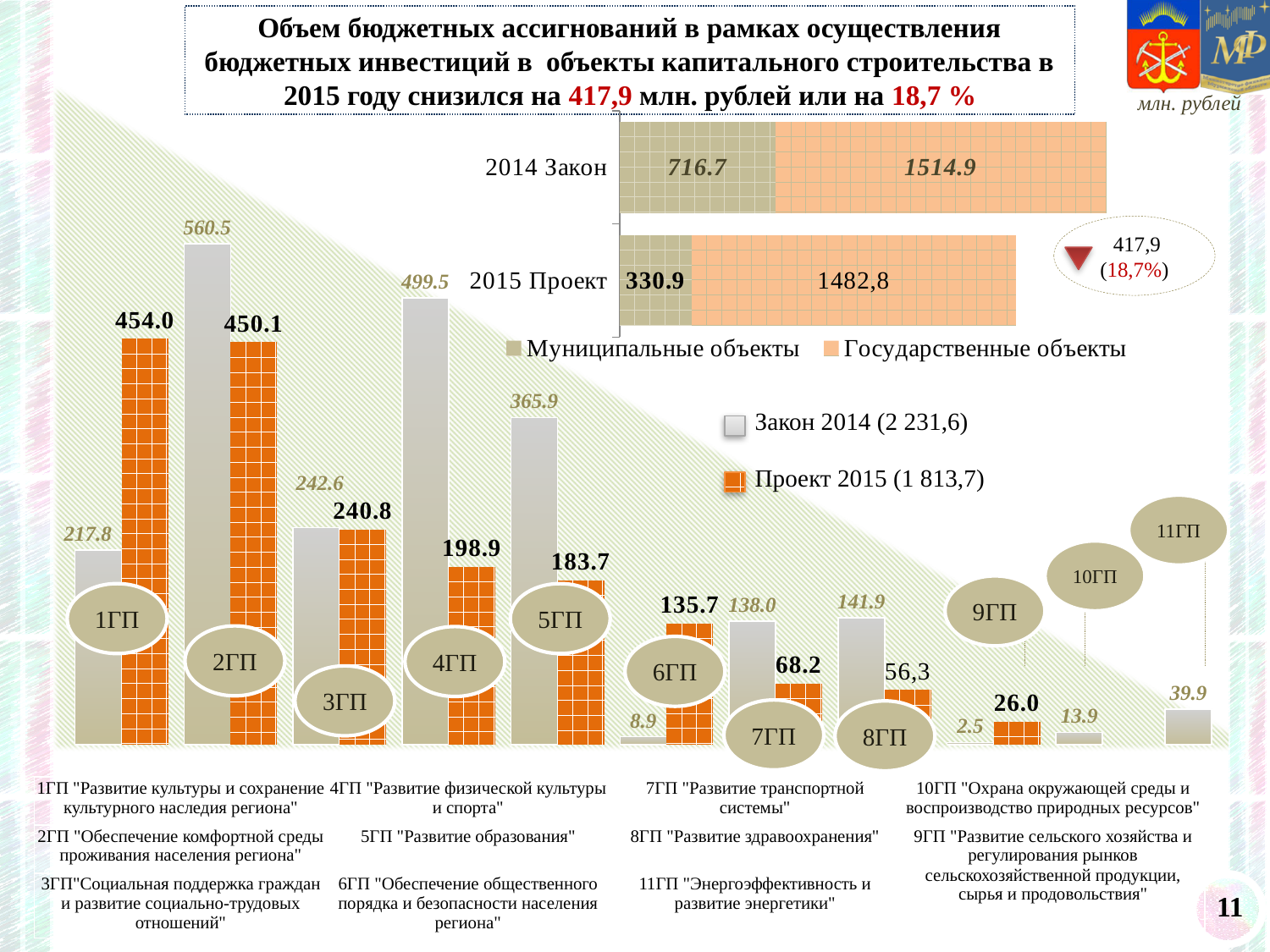
In the grouped bar chart by ГП, which ГП has the highest Закон 2014 value? 2ГП In the stacked horizontal bar chart at the top, by how much did Муниципальные объекты decrease from 2014 Закон to 2015 Проект? 385.8 In the stacked horizontal bar chart at the top, what is the value for Муниципальные объекты in 2014 Закон? 716.7 In the grouped bar chart by ГП, which ГП has the lowest Закон 2014 value? 9ГП In the stacked horizontal bar chart at the top, what is the value for Государственные объекты in 2015 Проект? 1482,8 In the grouped bar chart by ГП, what is the Закон 2014 value for 4ГП? 499.5 In the grouped bar chart by ГП, what is the difference between the Закон 2014 and Проект 2015 values for 5ГП? 182.2 In the grouped bar chart by ГП, what is the Проект 2015 value for 1ГП? 454.0 In the stacked horizontal bar chart at the top, what is the total of the 2014 Закон bar? 2 231,6 In the grouped bar chart by ГП, which is larger for 6ГП: the Закон 2014 value or the Проект 2015 value? Проект 2015 In the stacked horizontal bar chart at the top, how many series does the legend list? 2 What kind of chart is the chart showing values by ГП? bar chart